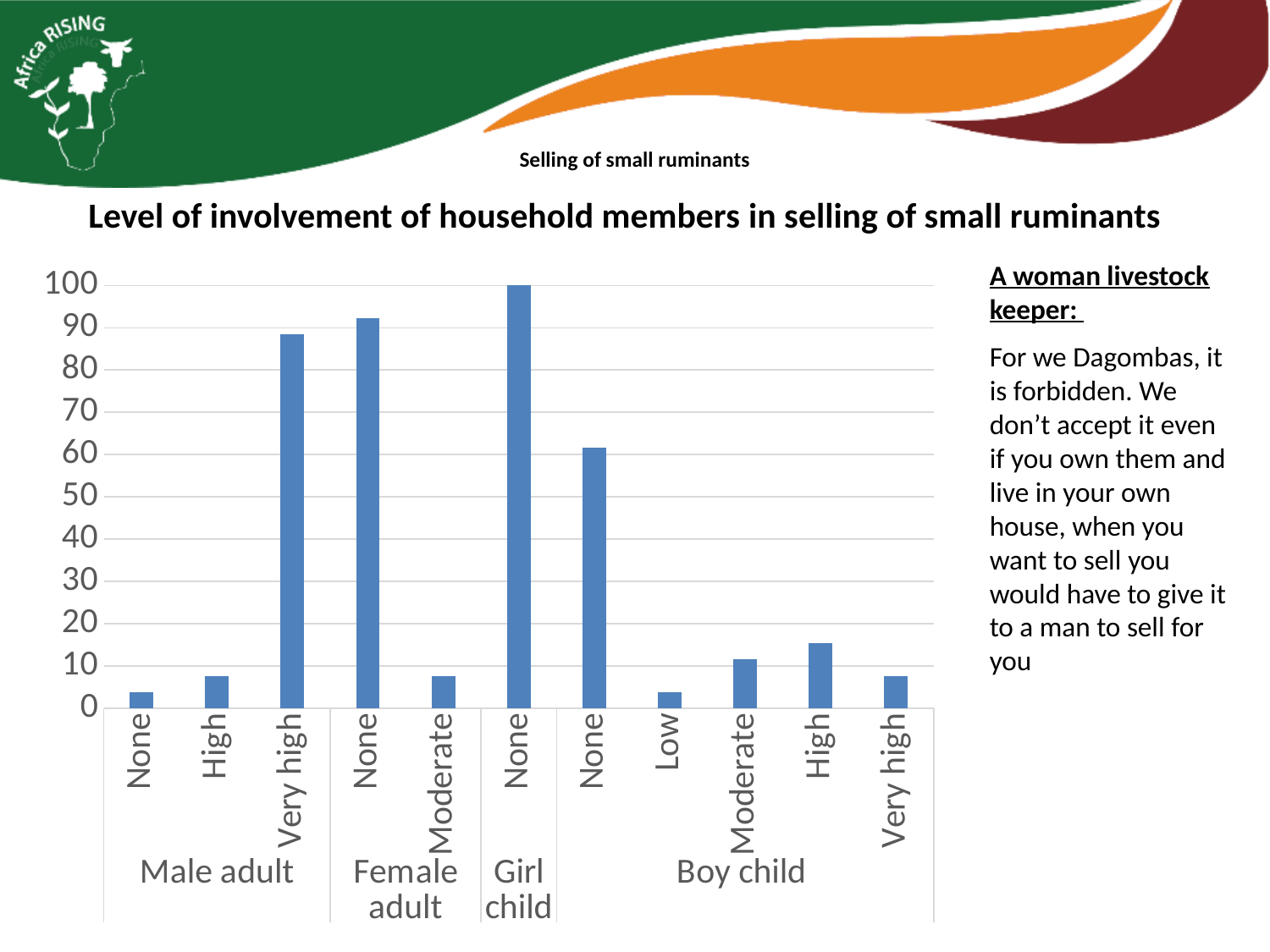
Is the value for 'None' under Female adult greater or less than 90? greater How many household member groups are shown along the x axis? 4 Is the value for 'High' under Boy child greater or less than 20? less What kind of chart is shown on the slide? bar chart What is the title of the chart? Level of involvement of household members in selling of small ruminants What is the value for 'None' under Girl child? 100 How many bars are plotted in the chart? 11 Which is larger: 'None' under Female adult or 'None' under Boy child? None under Female adult Is the value for 'Very high' under Male adult greater or less than 80? greater Which bar has the highest value in the chart? Girl child – None Which is larger: 'Very high' under Male adult or 'Very high' under Boy child? Very high under Male adult